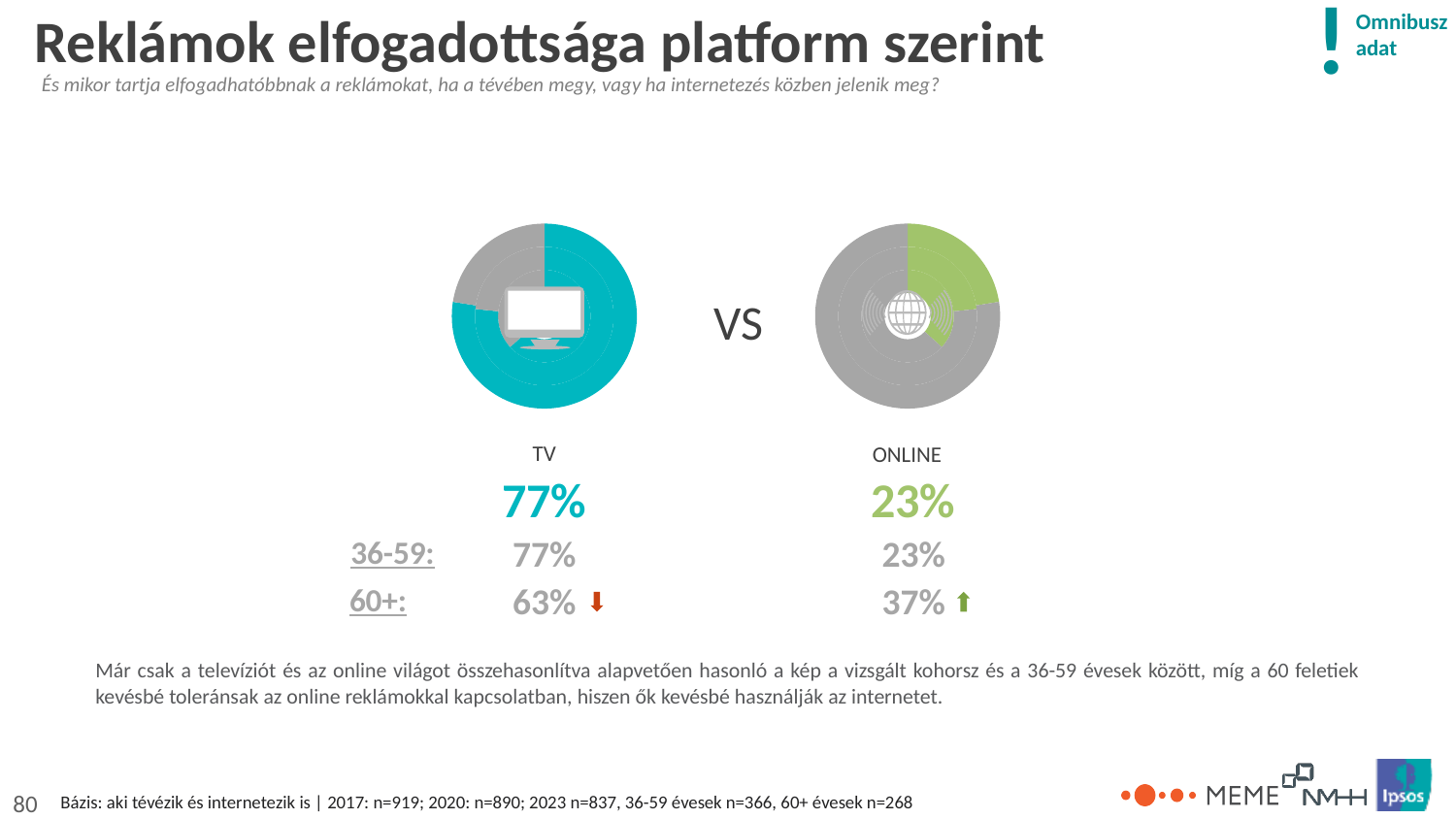
What is the TV value for the 60+ age group? 63% Which platform has the higher share, TV or ONLINE? TV What is the difference between the TV value for the 36-59 group and the TV value for the 60+ group? 14% What percentage is shown for ONLINE on the slide? 23% What is the ONLINE value for the 60+ age group? 37% What percentage is shown for TV on the slide? 77% What colour is the highlighted slice in the ONLINE pie chart? Green What kind of chart is used to show the TV and ONLINE shares? Doughnut chart What is the ONLINE value for the 36-59 age group? 23% What is the total of the TV and ONLINE shares for the 60+ age group? 100% How many pie charts are shown on the slide? 2 What is the difference between the TV share and the ONLINE share? 54%